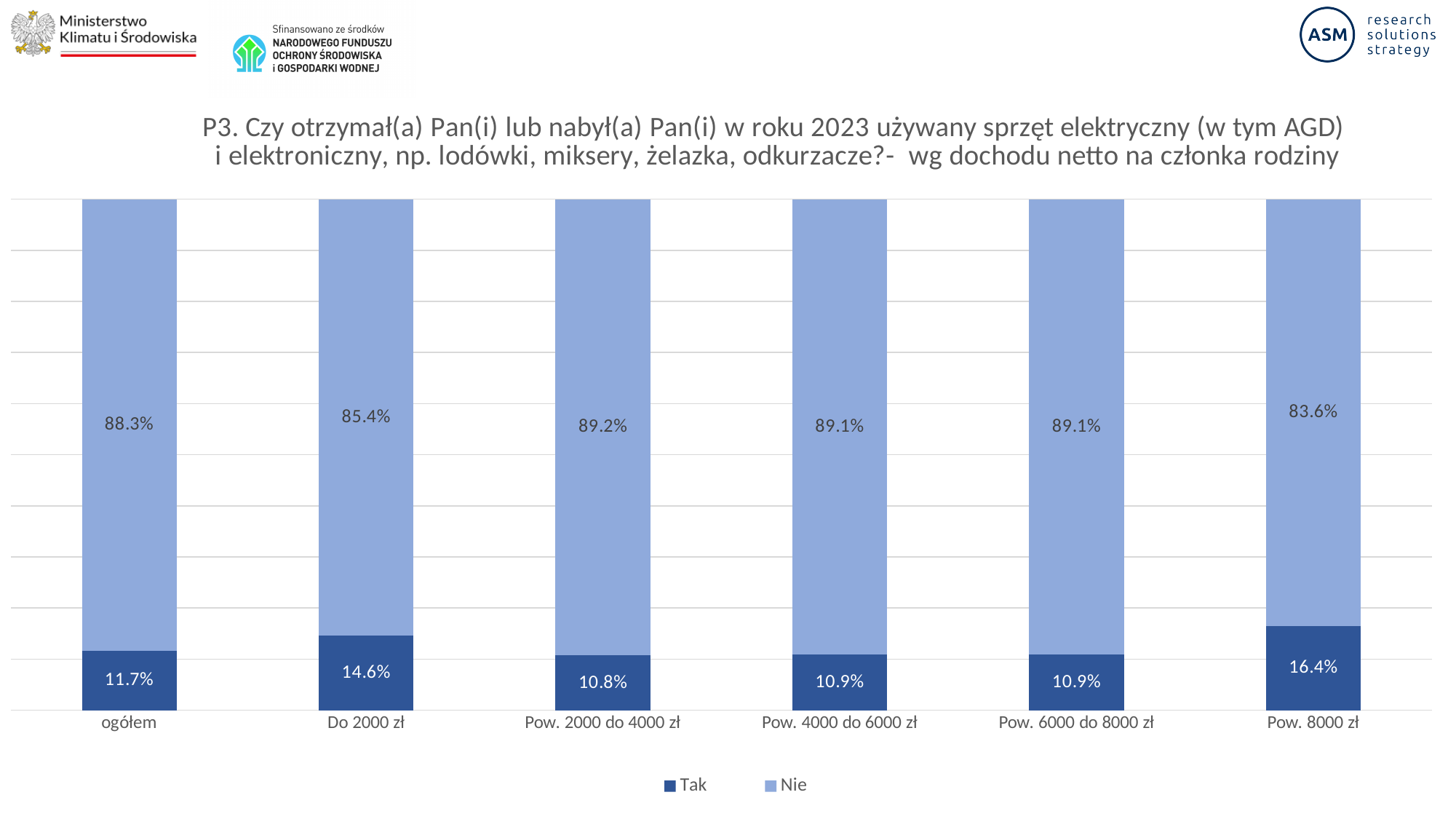
How many series does the legend list? 2 What kind of chart is shown on the slide? Stacked bar chart What is the total of the stacked bar for 'Pow. 4000 do 6000 zł'? 100.0% What is the 'Nie' value for 'Pow. 2000 do 4000 zł'? 89.2% What is the 'Nie' value for 'Do 2000 zł'? 85.4% Which category has the lowest 'Tak' value? Pow. 2000 do 4000 zł How many categories are shown on the x axis? 6 What is the difference between the 'Tak' values for 'Pow. 8000 zł' and 'Do 2000 zł'? 1.8% What is the 'Tak' value for 'Pow. 8000 zł'? 16.4% What is the 'Tak' value for 'ogółem'? 11.7% Which category has the highest 'Tak' value? Pow. 8000 zł Which is larger: the 'Nie' value for 'ogółem' or the 'Nie' value for 'Pow. 8000 zł'? ogółem